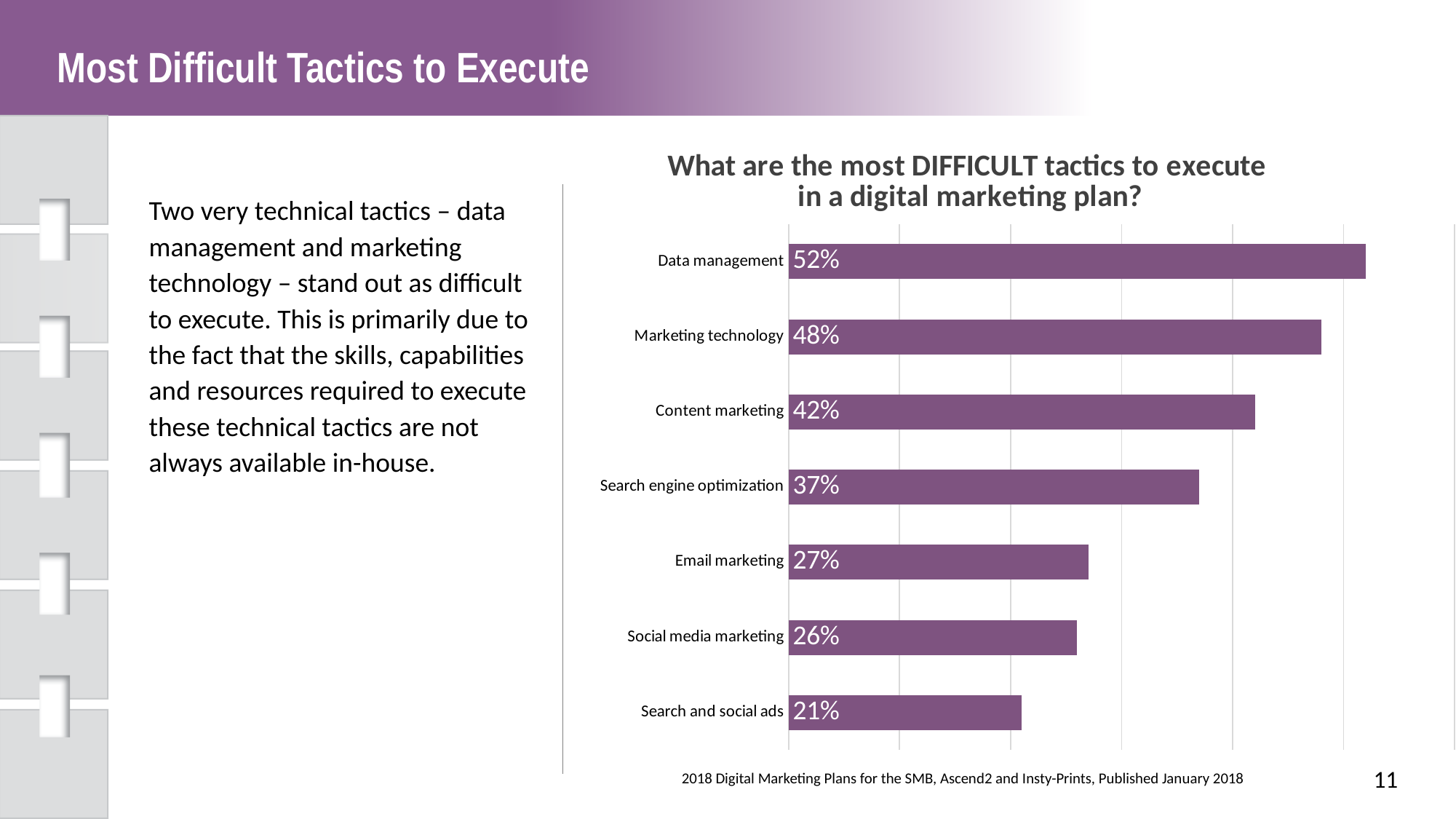
How many tactics are shown in the chart? 7 What is the difference between the values for Data management and Marketing technology? 4% What is the difference between the values for Content marketing and Search and social ads? 21% Which tactic has the lowest value in the chart? Search and social ads Which tactic has the highest value in the chart? Data management What is the value shown for Email marketing? 27% Which has a larger value, Search and social ads or Email marketing? Email marketing Which has a larger value, Content marketing or Search engine optimization? Content marketing What is the value shown for Search engine optimization? 37% What kind of chart is shown on the slide? Bar chart What percentage of respondents said data management is among the most difficult tactics to execute? 52% What is the title of the chart? What are the most DIFFICULT tactics to execute in a digital marketing plan?